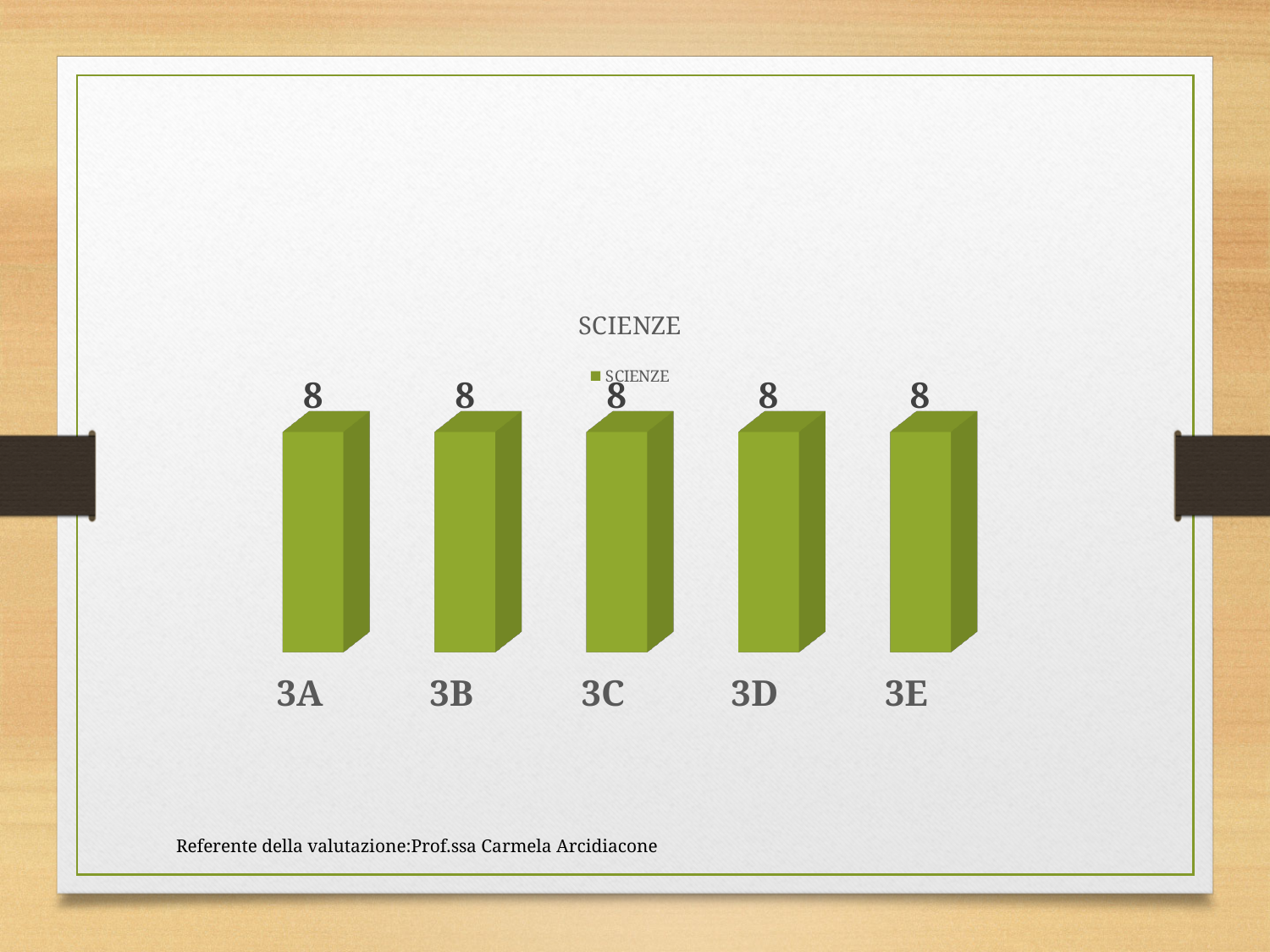
What is the value for 3C? 8 What is the value for 3A? 8 What is the name of the series listed in the legend? SCIENZE What is the title of the chart? SCIENZE What kind of chart is shown on the slide? bar chart Do the values rise, fall or stay the same from 3A to 3E? stay the same How many series does the legend list? 1 What is the difference between the values for 3B and 3D? 0 How many categories are shown on the x axis? 5 Is the value for 3D greater or less than 5? greater What is the value for 3E? 8